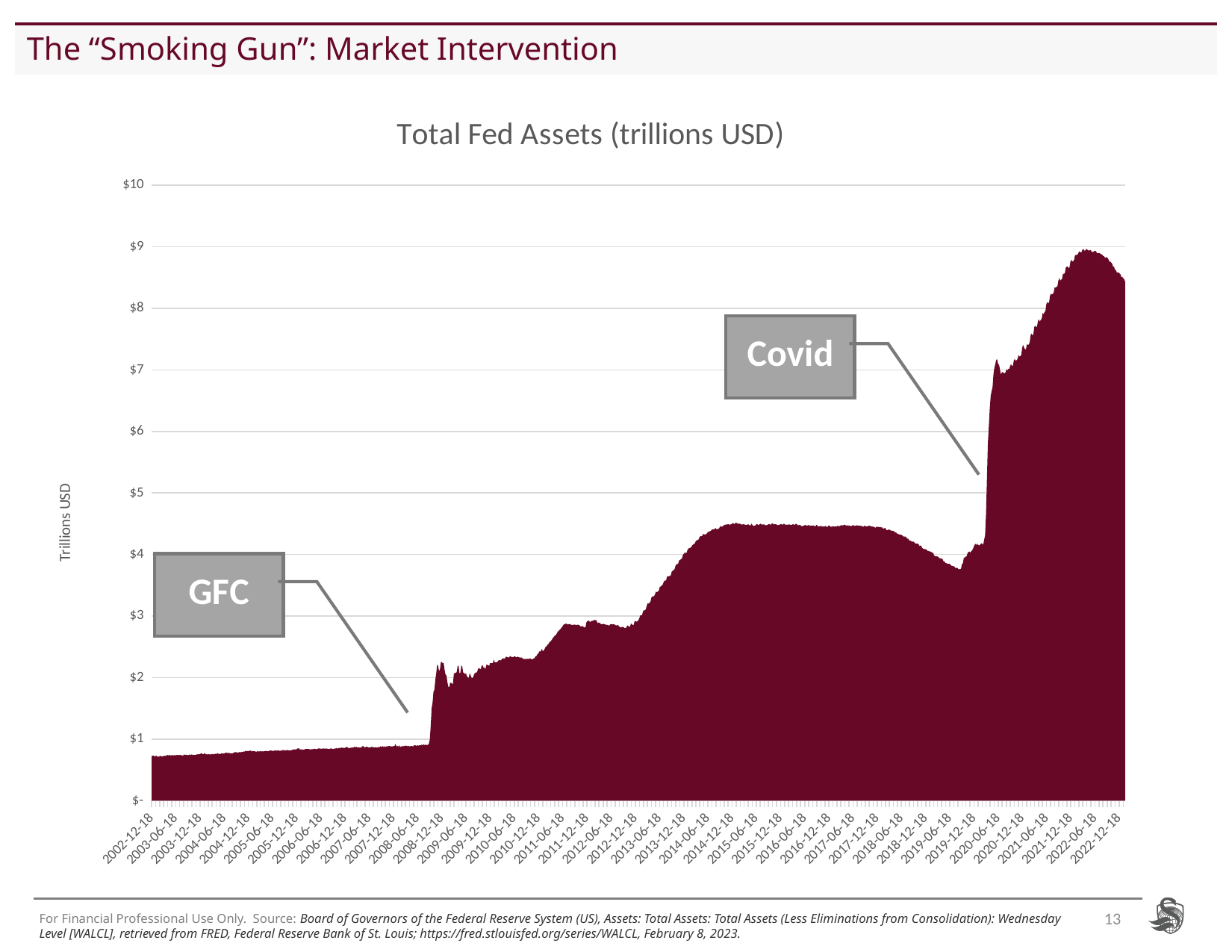
What kind of chart is shown on the slide? Area chart Is the value for 2002-12-18 greater or less than $1? less Is the value for 2015-12-18 greater or less than $4? greater Overall, do Total Fed Assets rise or fall from 2002-12-18 to 2022-12-18? rise What is the title of the chart? Total Fed Assets (trillions USD) Which is larger, the value for 2022-06-18 or the value for 2002-12-18? 2022-06-18 What is the highest value shown on the vertical axis of the chart? $10 Is the value for 2007-12-18 greater or less than $2? less What label is shown on the vertical axis of the chart? Trillions USD